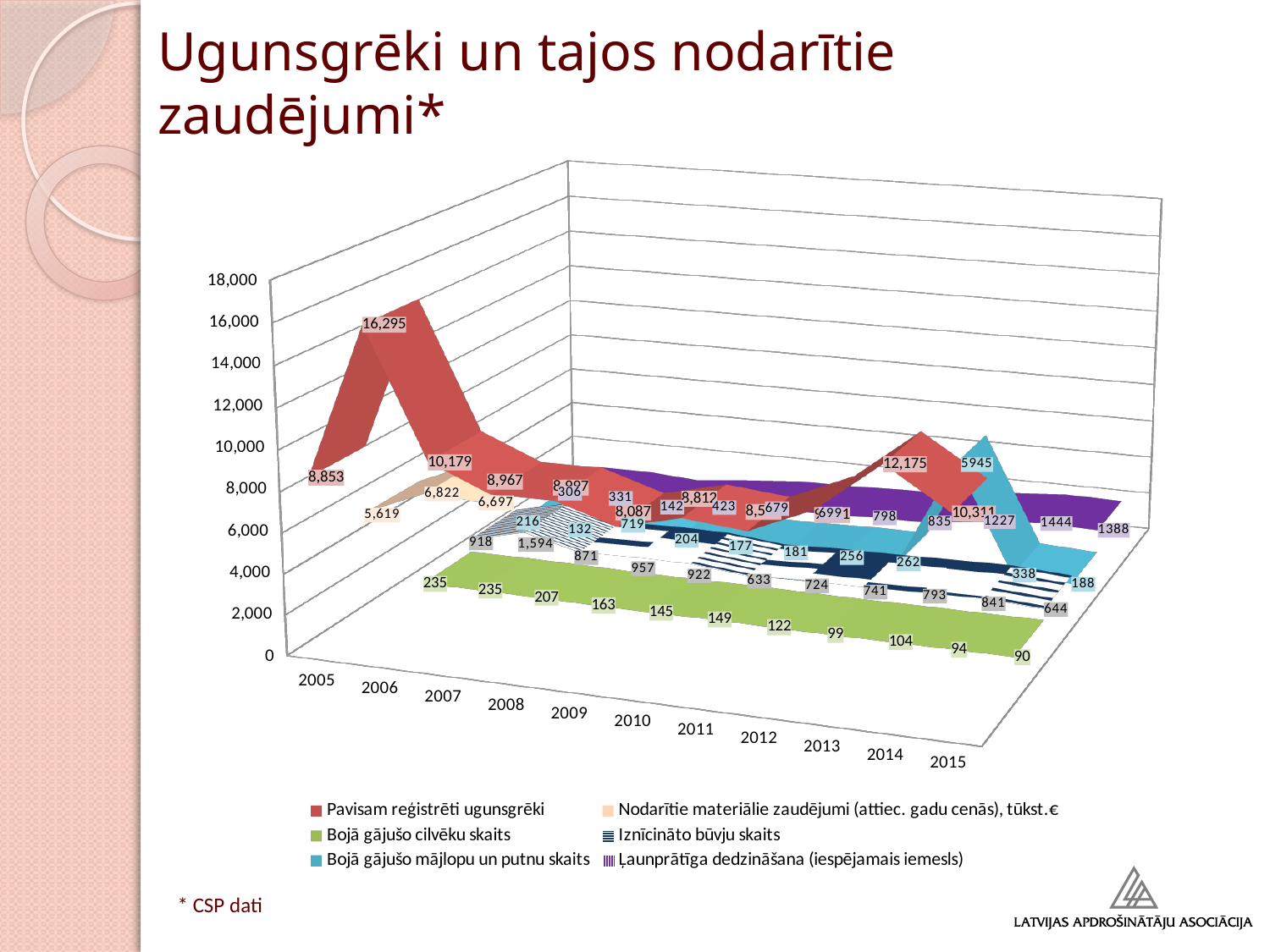
What is the value of 'Bojā gājušo cilvēku skaits' in 2015? 90 How many series does the legend list? 6 In which year is 'Pavisam reģistrēti ugunsgrēki' highest? 2006 Which is larger: 'Pavisam reģistrēti ugunsgrēki' in 2006 or in 2007? 2006 Does 'Bojā gājušo cilvēku skaits' generally rise or fall from 2005 to 2015? fall What is the value of 'Pavisam reģistrēti ugunsgrēki' in 2006? 16,295 What is the value of 'Bojā gājušo cilvēku skaits' in 2005? 235 What is the title of the chart slide? Ugunsgrēki un tajos nodarītie zaudējumi* What kind of chart is shown on the slide? 3D line chart In which year is 'Bojā gājušo cilvēku skaits' lowest? 2015 What is the difference between 'Bojā gājušo cilvēku skaits' in 2005 and in 2015? 145 How many years are shown along the x axis? 11